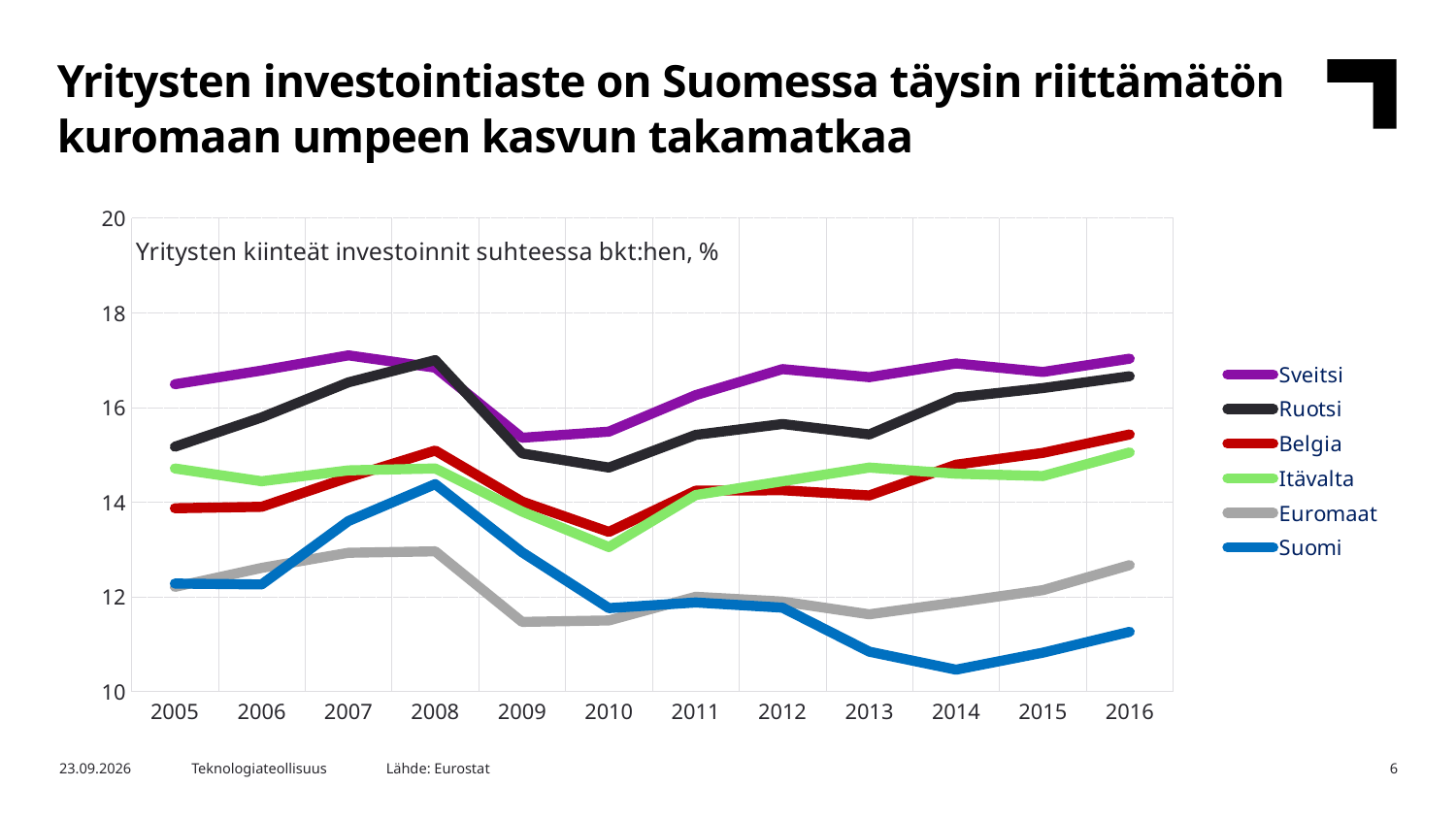
Is the value for Sveitsi in 2016 greater or less than 16? greater Does the value for Suomi rise or fall from 2011 to 2014? fall Which is larger in 2014, the value for Ruotsi or the value for Belgia? Ruotsi Is the value for Ruotsi in 2008 greater or less than 16? greater What kind of chart is shown on the slide? line chart Which series has the lowest value in 2016? Suomi How many years are shown on the x axis? 12 What is the title text shown inside the chart area? Yritysten kiinteät investoinnit suhteessa bkt:hen, % Is the value for Euromaat in 2009 greater or less than 12? less How many series does the legend list? 6 Which series has the lowest value in 2014? Suomi